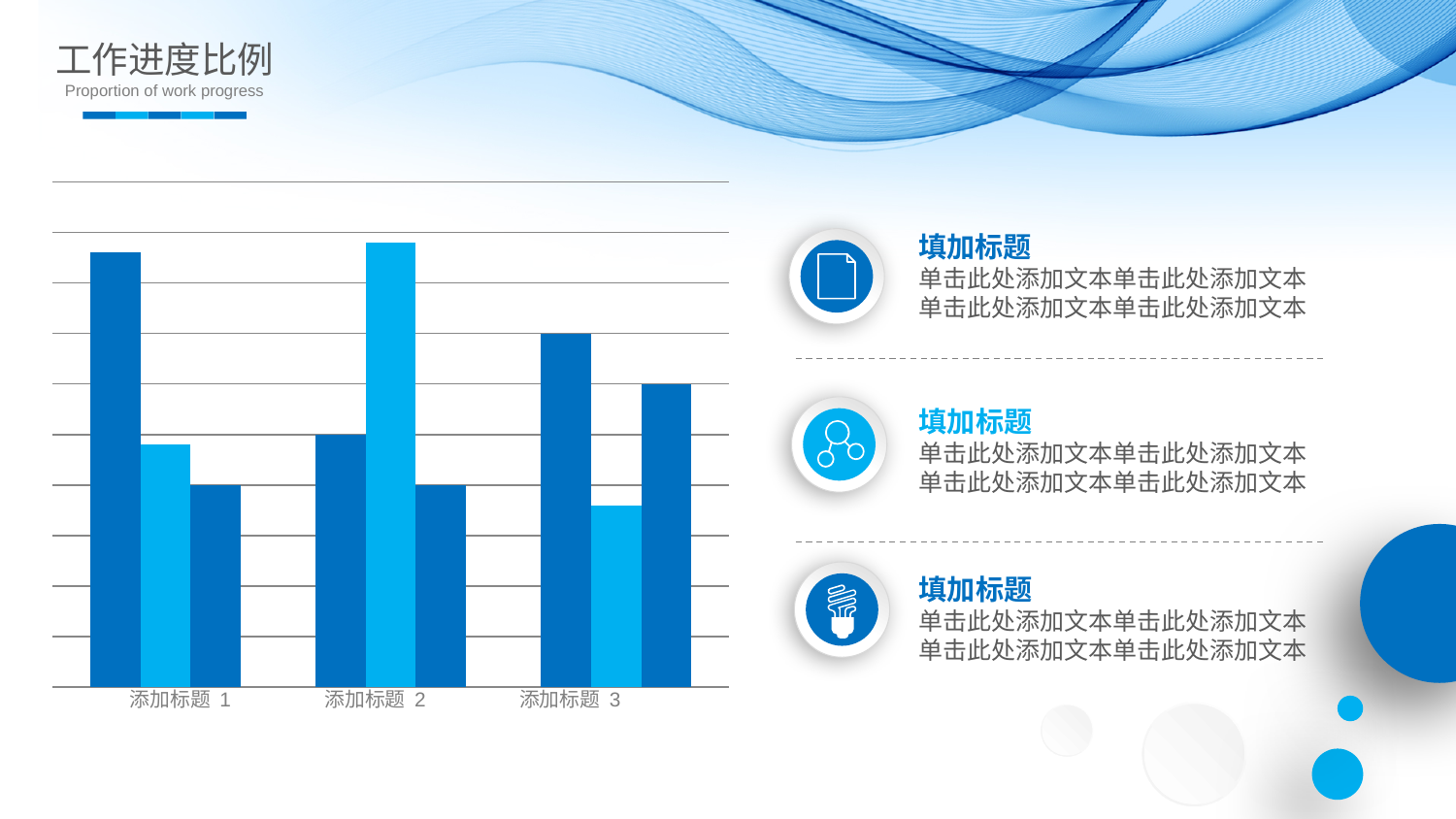
How many bars are plotted in total on the chart? 9 In the 添加标题 2 group, which bar is the tallest? The second (light blue) bar Which category contains the tallest bar on the chart? 添加标题 2 In the 添加标题 3 group, which bar is the shortest? The second (light blue) bar What is the label of the leftmost category on the x axis? 添加标题 1 Does the chart display a legend? No Is the first (dark blue) bar taller in 添加标题 1 or in 添加标题 3? 添加标题 1 What kind of chart is shown on the slide? Bar chart How does the height of the second (light blue) bar change from 添加标题 1 to 添加标题 2 to 添加标题 3? It rises, then falls How many categories are shown on the x axis of the bar chart? 3 In the 添加标题 1 group, which bar is the tallest? The first (dark blue) bar In the 添加标题 1 group, is the second (light blue) bar taller or shorter than the third bar? Taller